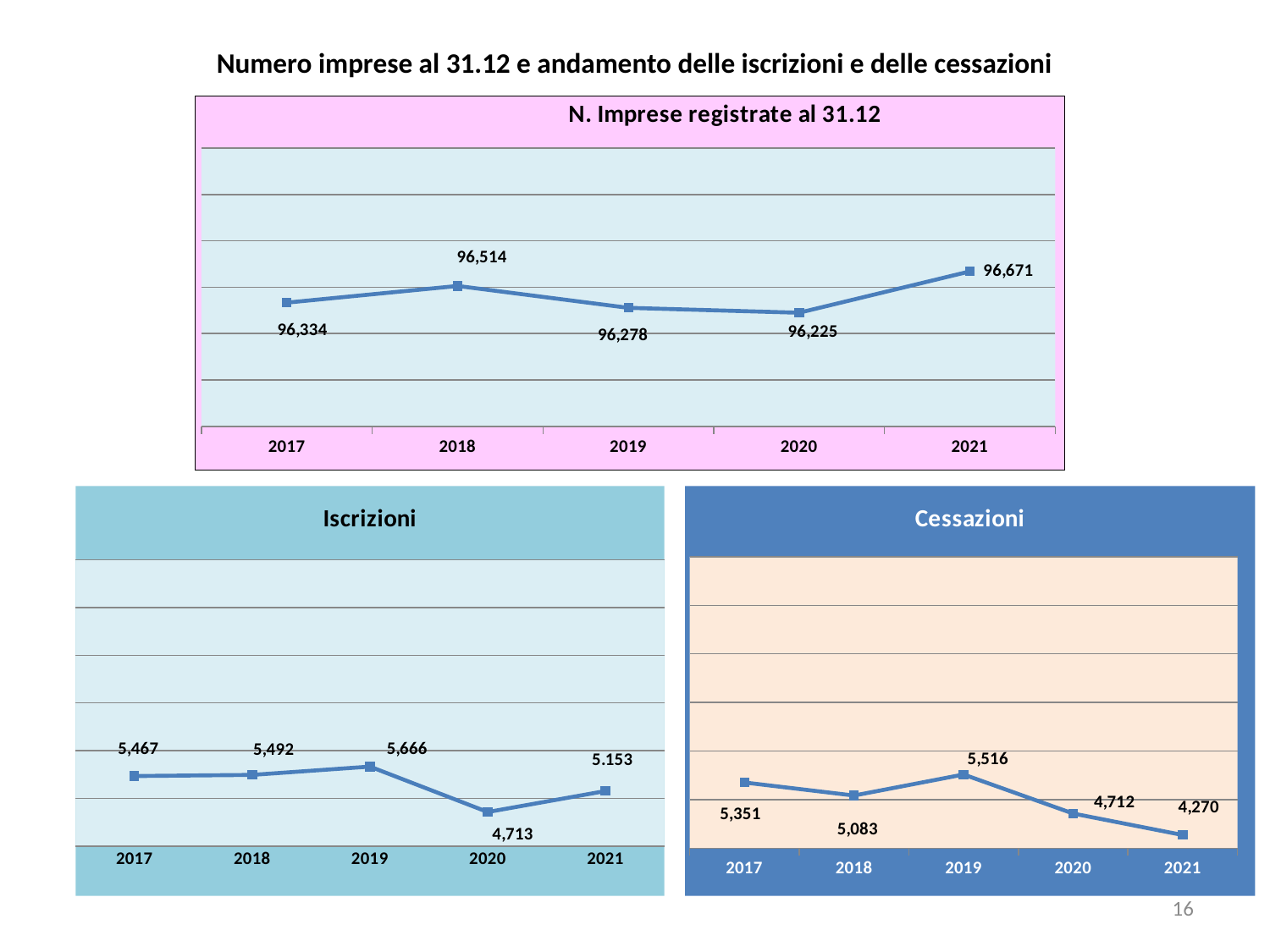
In the 'Iscrizioni' chart, which year has the highest value? 2019 In the 'Cessazioni' chart, do the values rise or fall from 2019 to 2021? fall What kind of chart is the 'N. Imprese registrate al 31.12' chart? line chart In the 'Cessazioni' chart, which year has the lowest value? 2021 How many years are plotted in the 'Iscrizioni' chart? 5 In the 'Iscrizioni' chart, what is the value for 2020? 4,713 In the 'Cessazioni' chart, is the value for 2017 larger or smaller than the value for 2019? smaller In the 'Cessazioni' chart, what is the value for 2018? 5,083 In the 'N. Imprese registrate al 31.12' chart, which year has the lowest value? 2020 In the 'N. Imprese registrate al 31.12' chart, what is the difference between the 2021 value and the 2017 value? 337 In the 'N. Imprese registrate al 31.12' chart, what is the value for 2018? 96,514 In the 'Iscrizioni' chart, what is the difference between the 2019 value and the 2018 value? 174